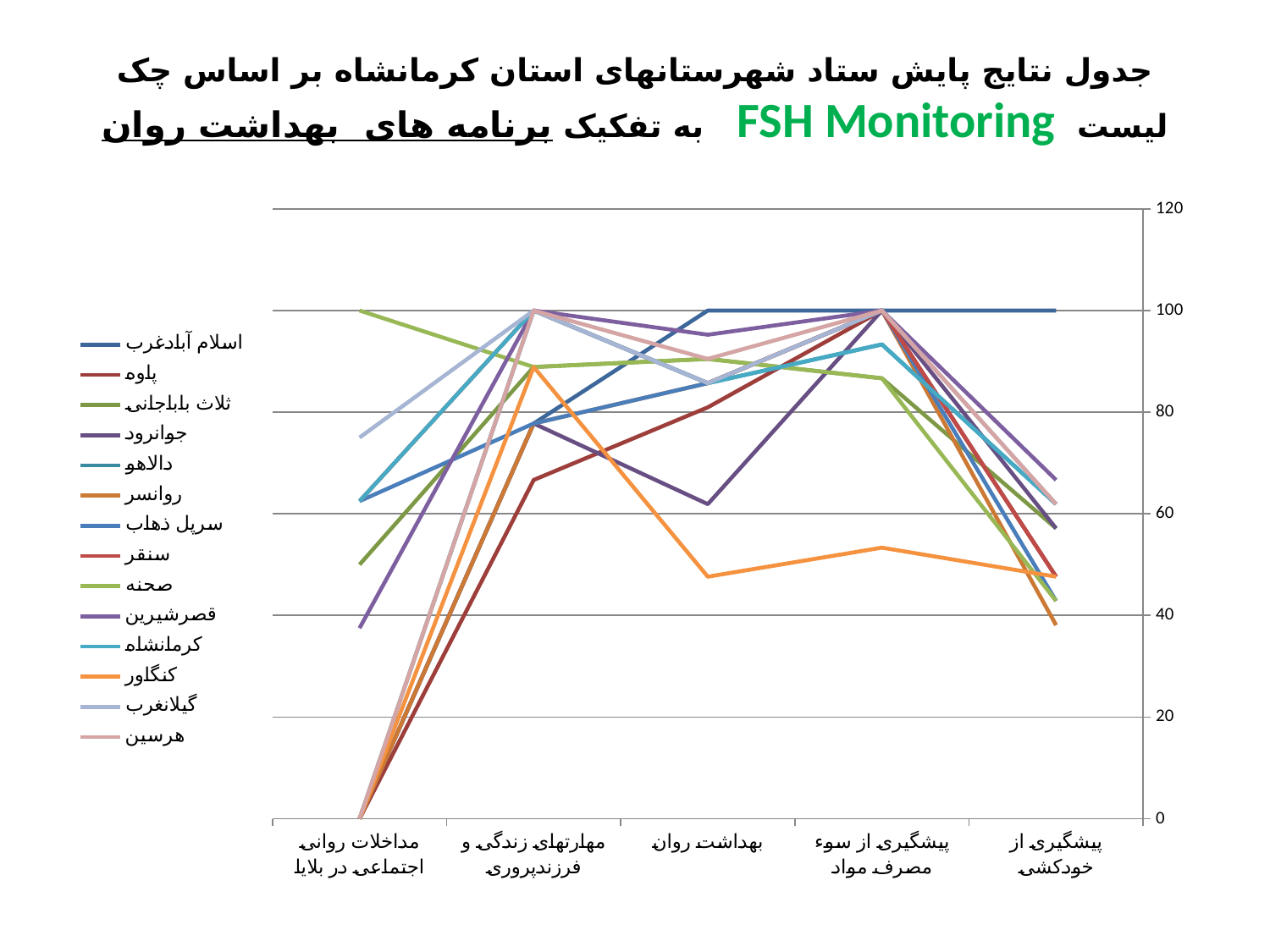
Which English phrase appears in green in the slide title? FSH Monitoring What kind of chart is shown on the slide? line chart What is the highest value shown on the chart's y axis? 120 Which category on the x axis is listed first (leftmost)? مداخلات روانی اجتماعی در بلایا Is the value for صحنه in the category پیشگیری از خودکشی greater or less than 60? less What is the value for صحنه in the category مداخلات روانی اجتماعی در بلایا? 100 How many series does the chart's legend list? 14 How many categories are shown along the x axis of the chart? 5 Is the value for صحنه in the category بهداشت روان greater or less than 80? greater